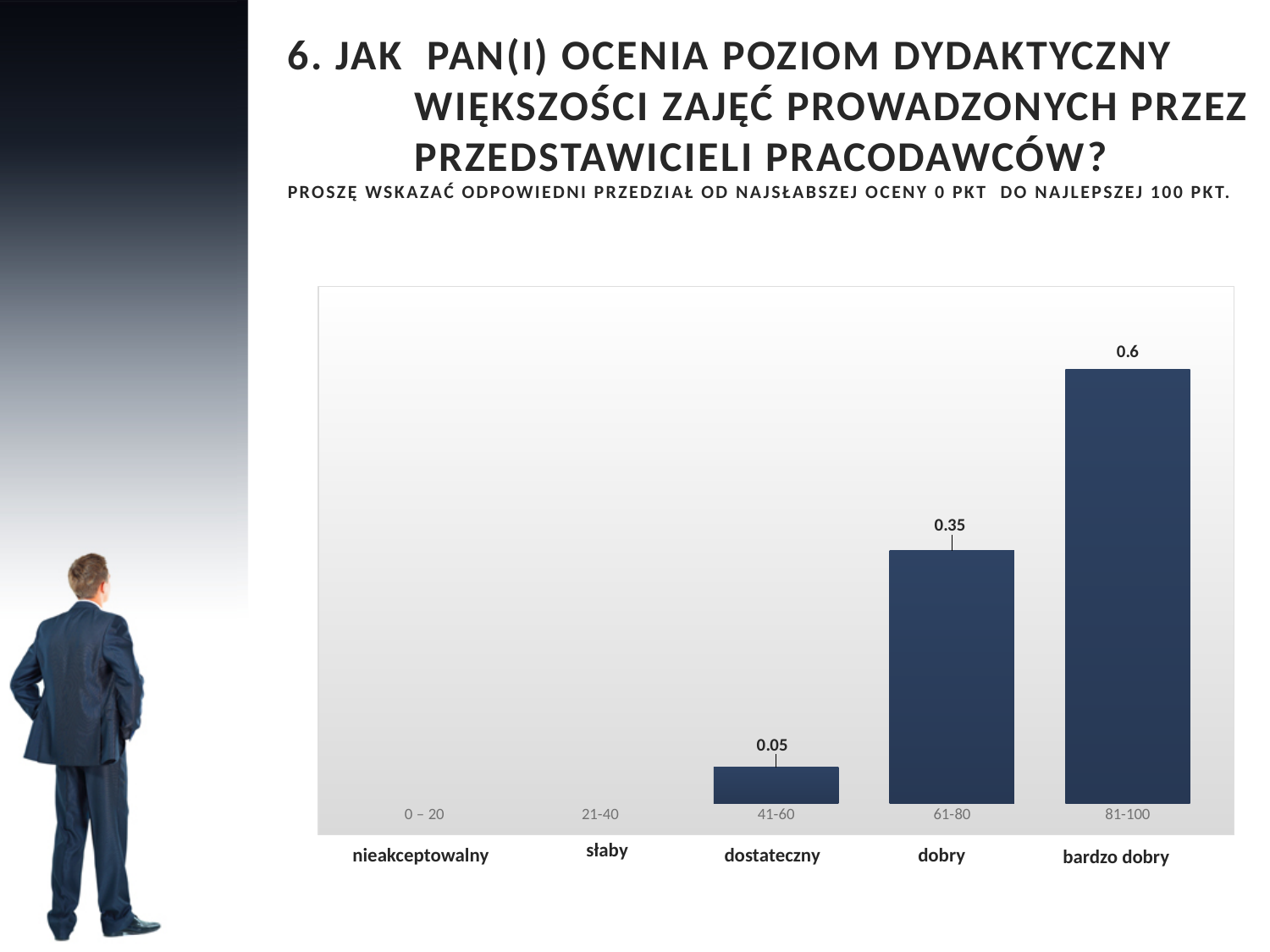
How many categories are shown on the x axis? 5 Which is larger, the value for 61-80 or the value for 41-60? 61-80 Do the values rise or fall moving from left to right along the x axis? rise What kind of chart is shown on the slide? bar chart What is the value for the 41-60 (dostateczny) category? 0.05 What is the value for the 61-80 (dobry) category? 0.35 What is the value for the 81-100 (bardzo dobry) category? 0.6 Which category has the highest value? 81-100 (bardzo dobry) Which categories have no visible bar? 0 – 20 and 21-40 What descriptive label is shown under the 41-60 category? dostateczny What is the difference between the values for 61-80 and 41-60? 0.3 What is the difference between the values for 81-100 and 61-80? 0.25